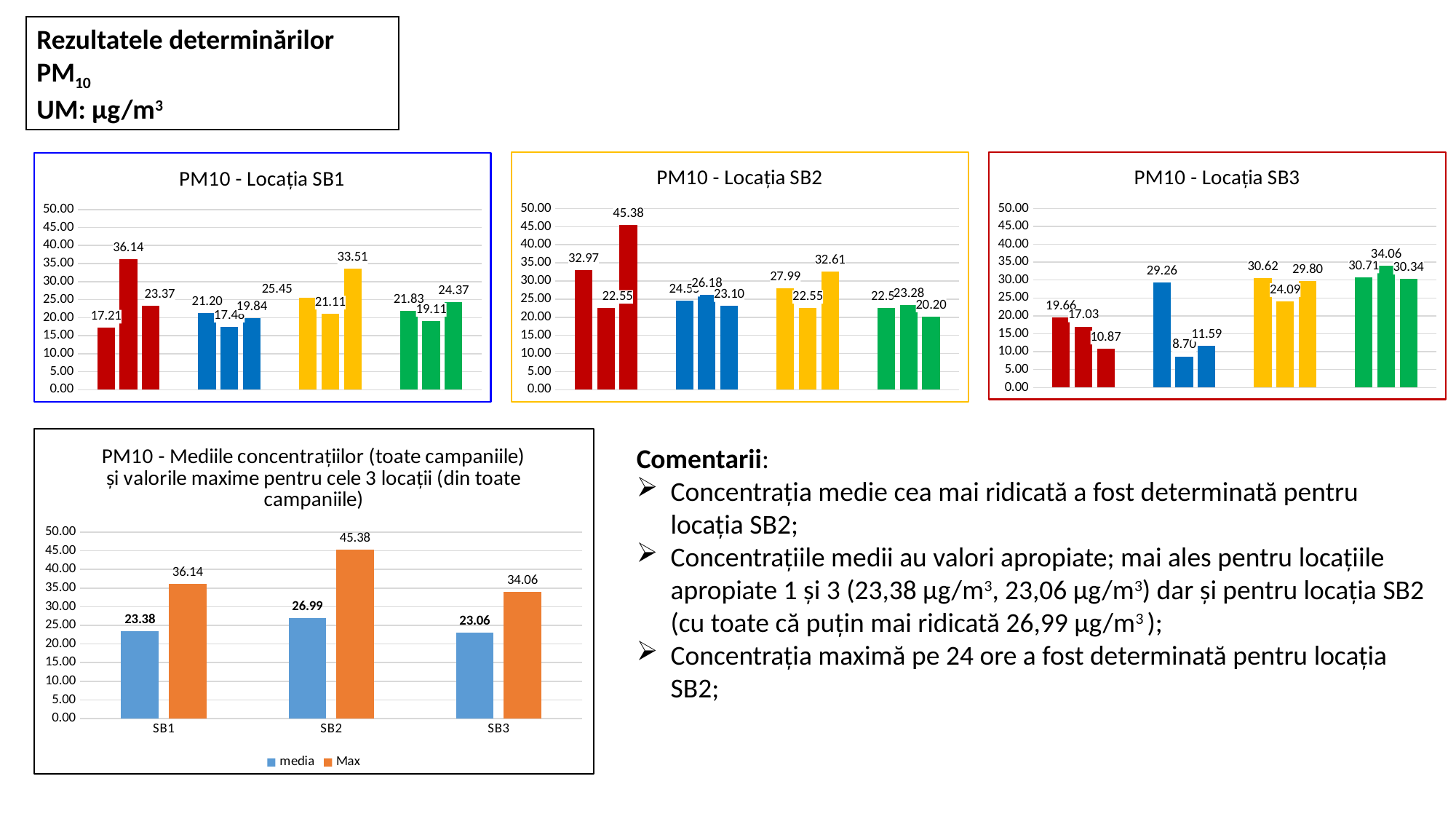
In the chart 'PM10 - Mediile concentrațiilor (toate campaniile) și valorile maxime pentru cele 3 locații', which location has the lowest 'Max' value? SB3 In the chart 'PM10 - Mediile concentrațiilor (toate campaniile) și valorile maxime pentru cele 3 locații', which is larger: the 'Max' value for SB1 or the 'Max' value for SB3? SB1 What kind of chart is 'PM10 - Locația SB2'? bar chart In the chart 'PM10 - Locația SB2', what is the highest value shown? 45.38 In the chart 'PM10 - Mediile concentrațiilor (toate campaniile) și valorile maxime pentru cele 3 locații', what is the 'media' value for SB2? 26.99 In the chart 'PM10 - Mediile concentrațiilor (toate campaniile) și valorile maxime pentru cele 3 locații', is the 'media' value for SB2 greater or less than 25.00? greater In the chart 'PM10 - Mediile concentrațiilor (toate campaniile) și valorile maxime pentru cele 3 locații', what is the 'Max' value for SB3? 34.06 In the chart 'PM10 - Mediile concentrațiilor (toate campaniile) și valorile maxime pentru cele 3 locații', which location has the highest 'Max' value? SB2 In the chart 'PM10 - Locația SB3', what is the lowest value shown? 8.70 In the chart 'PM10 - Mediile concentrațiilor (toate campaniile) și valorile maxime pentru cele 3 locații', what is the difference between the 'Max' and 'media' values for SB2? 18.39 How many series does the legend list in the chart 'PM10 - Mediile concentrațiilor (toate campaniile) și valorile maxime pentru cele 3 locații'? 2 How many locations are shown on the x axis of the chart 'PM10 - Mediile concentrațiilor (toate campaniile) și valorile maxime pentru cele 3 locații'? 3